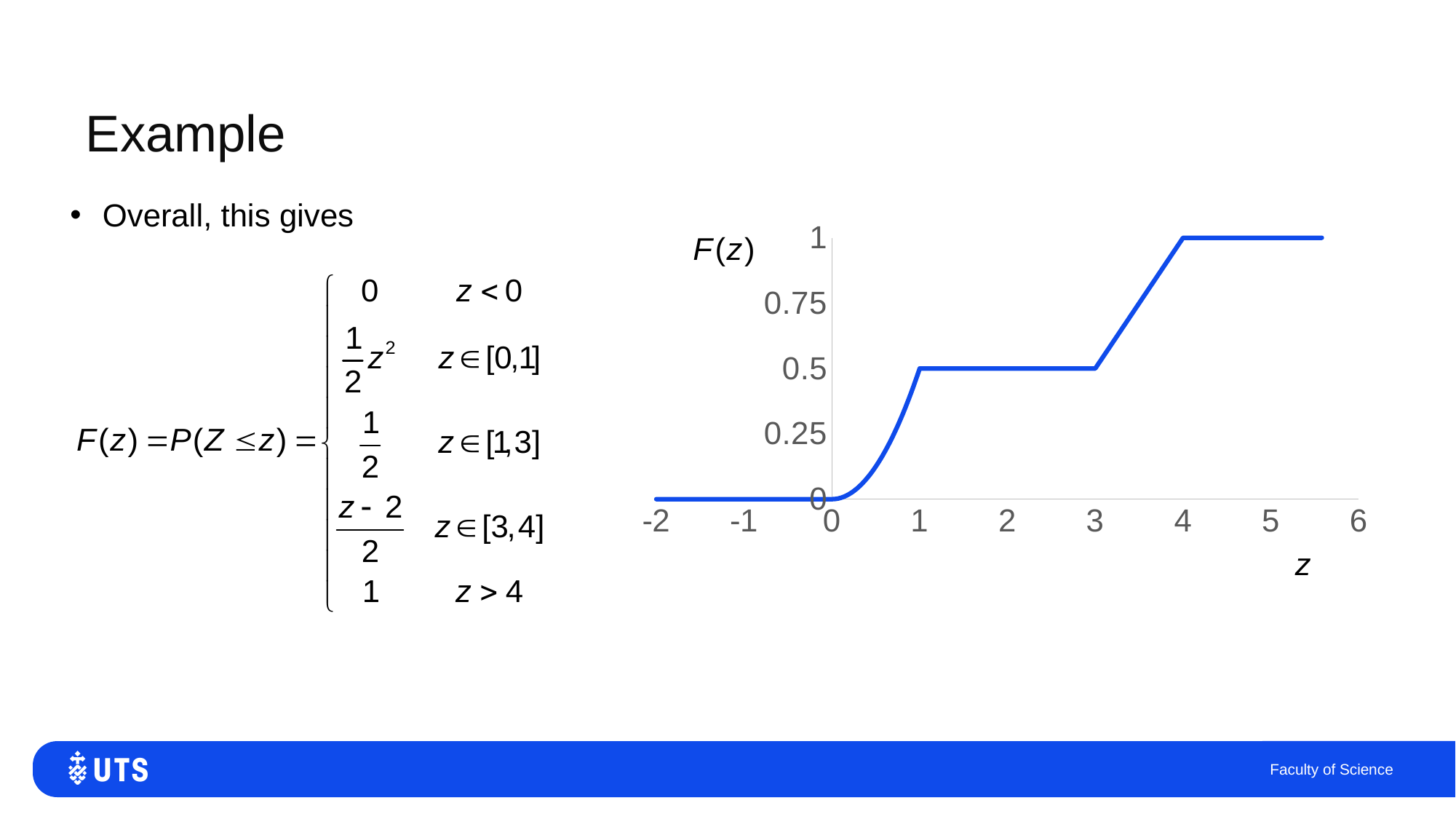
What is the difference between F(z) at z = 4 and F(z) at z = 3 on the chart? 0.5 What kind of chart is shown on the slide? line chart Which is larger on the chart: F(z) at z = 2 or F(z) at z = 4? z = 4 What is the value of F(z) at z = 5 on the chart? 1 What is the value of F(z) at z = 2 on the chart? 0.5 Is the value of F(z) at z = 0.5 greater or less than 0.25? less What label is shown on the horizontal axis of the chart? z What is the value of F(z) at z = -1 on the chart? 0 Does the plotted line rise or fall overall as z increases from -2 to 6? rise Is the value of F(z) at z = 3.5 greater or less than 0.5? greater What is the value of F(z) at z = 1 on the chart? 0.5 What is the highest tick value shown on the vertical axis of the chart? 1